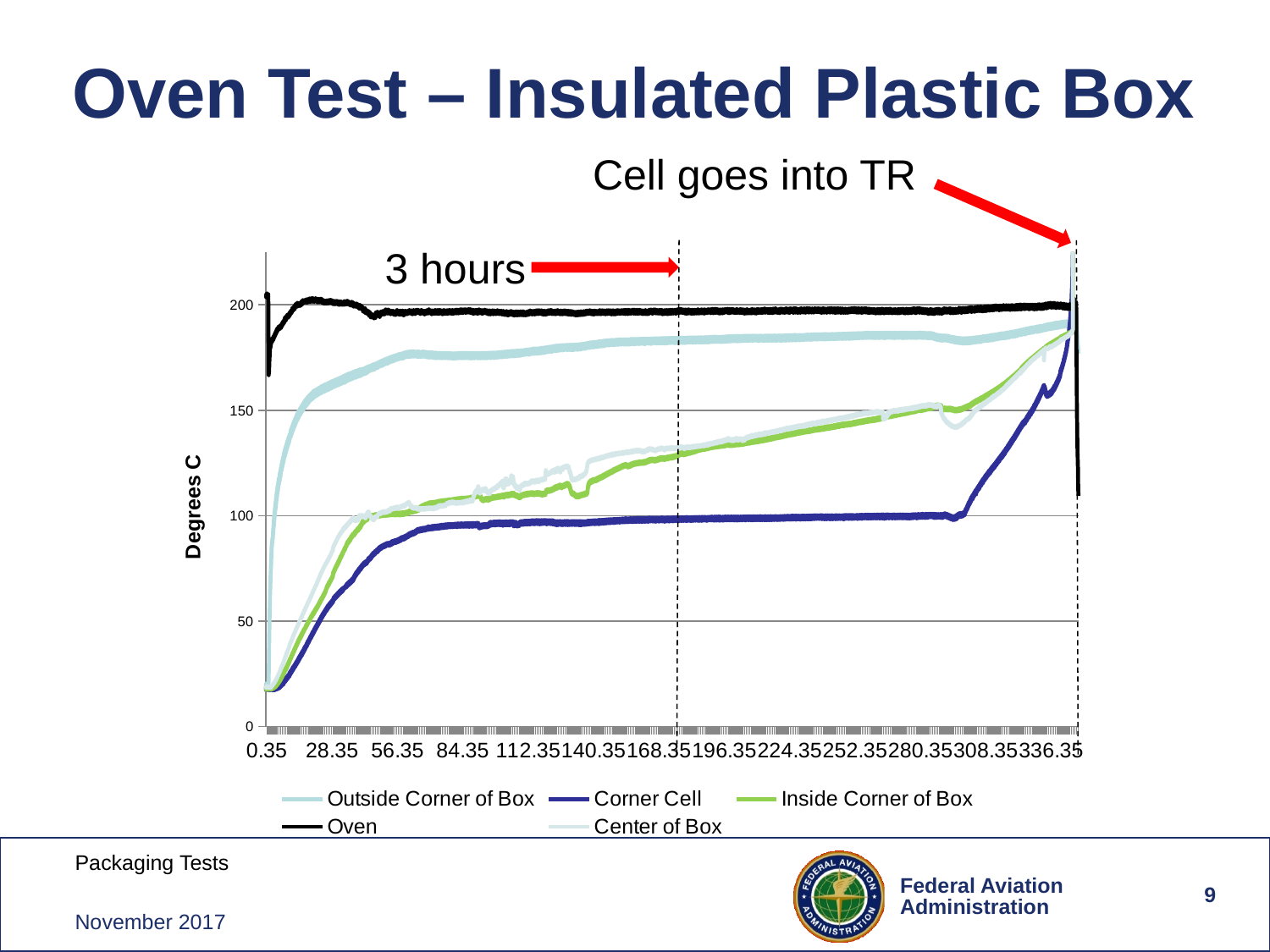
Is the value for Outside Corner of Box at 168.35 greater or less than 150? greater Is the value for Corner Cell at 168.35 greater or less than 150? less What kind of chart is shown on the slide? line chart What is the title of the chart's vertical axis? Degrees C At 168.35, which is larger: Outside Corner of Box or Inside Corner of Box? Outside Corner of Box Is the value for Inside Corner of Box at 168.35 greater or less than 100? greater Does the Corner Cell series rise or fall between 0.35 and 168.35? rise Which series is drawn in black according to the legend? Oven Which series has the lowest temperature for most of the test? Corner Cell Which series has the highest temperature for most of the test? Oven How many series does the legend list? 5